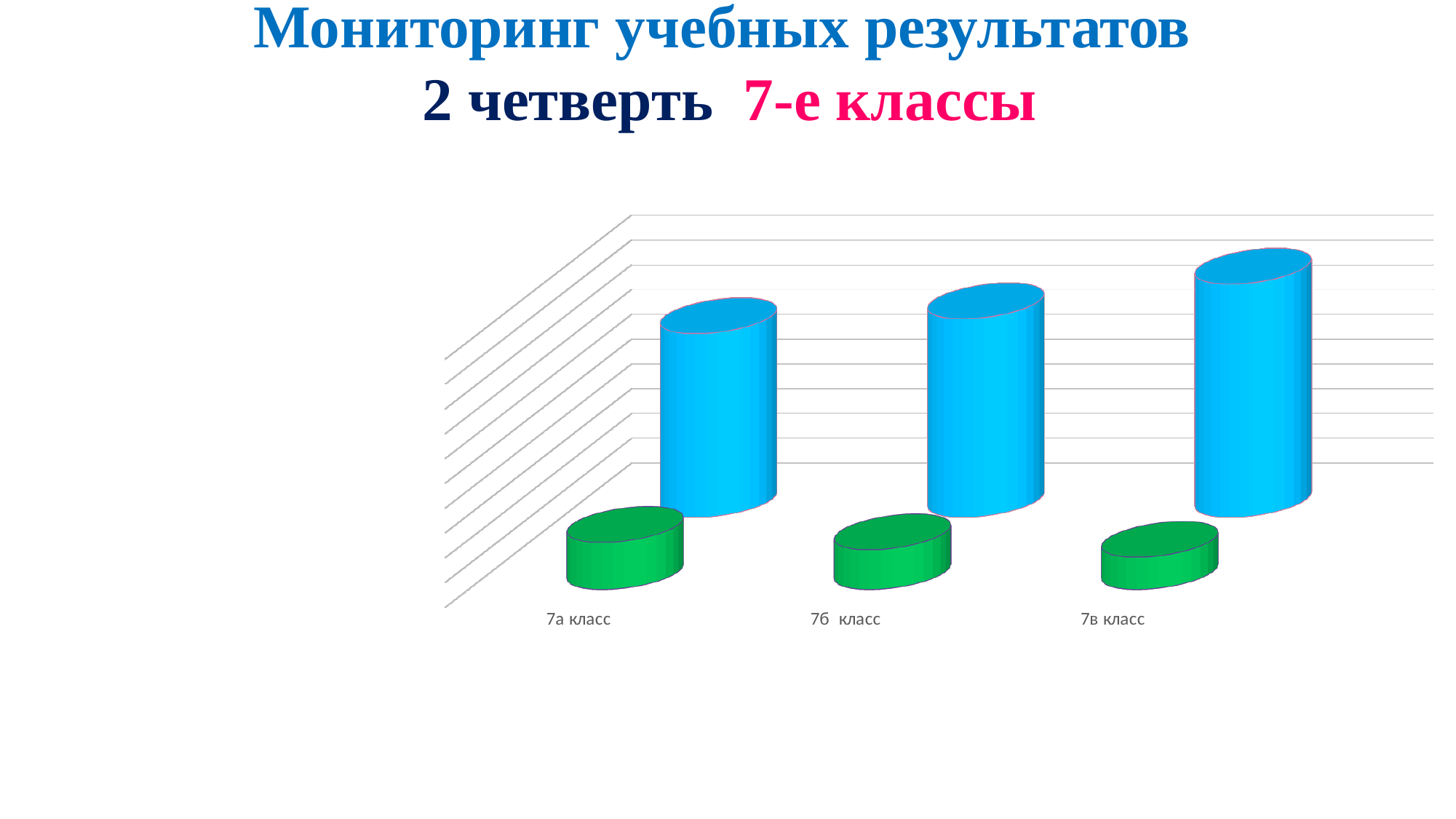
Which class has the shortest blue bar in the chart? 7а класс Which class has the shortest green bar in the chart? 7в класс For 7а класс, which bar is taller, the blue one or the green one? the blue one Which class has the tallest blue bar in the chart? 7в класс Is the blue bar for 7б класс taller or shorter than the blue bar for 7а класс? taller How many categories (classes) are shown on the x axis of the chart? 3 How many data series (bar colours) are plotted for each class in the chart? 2 Do the blue bars rise or fall from 7а класс to 7в класс along the x axis? rise Is the blue bar for 7б класс taller or shorter than the blue bar for 7в класс? shorter What kind of chart is shown on the slide? bar chart What two colours are used for the bars in the chart? blue and green Do the green bars rise or fall from 7а класс to 7в класс along the x axis? fall